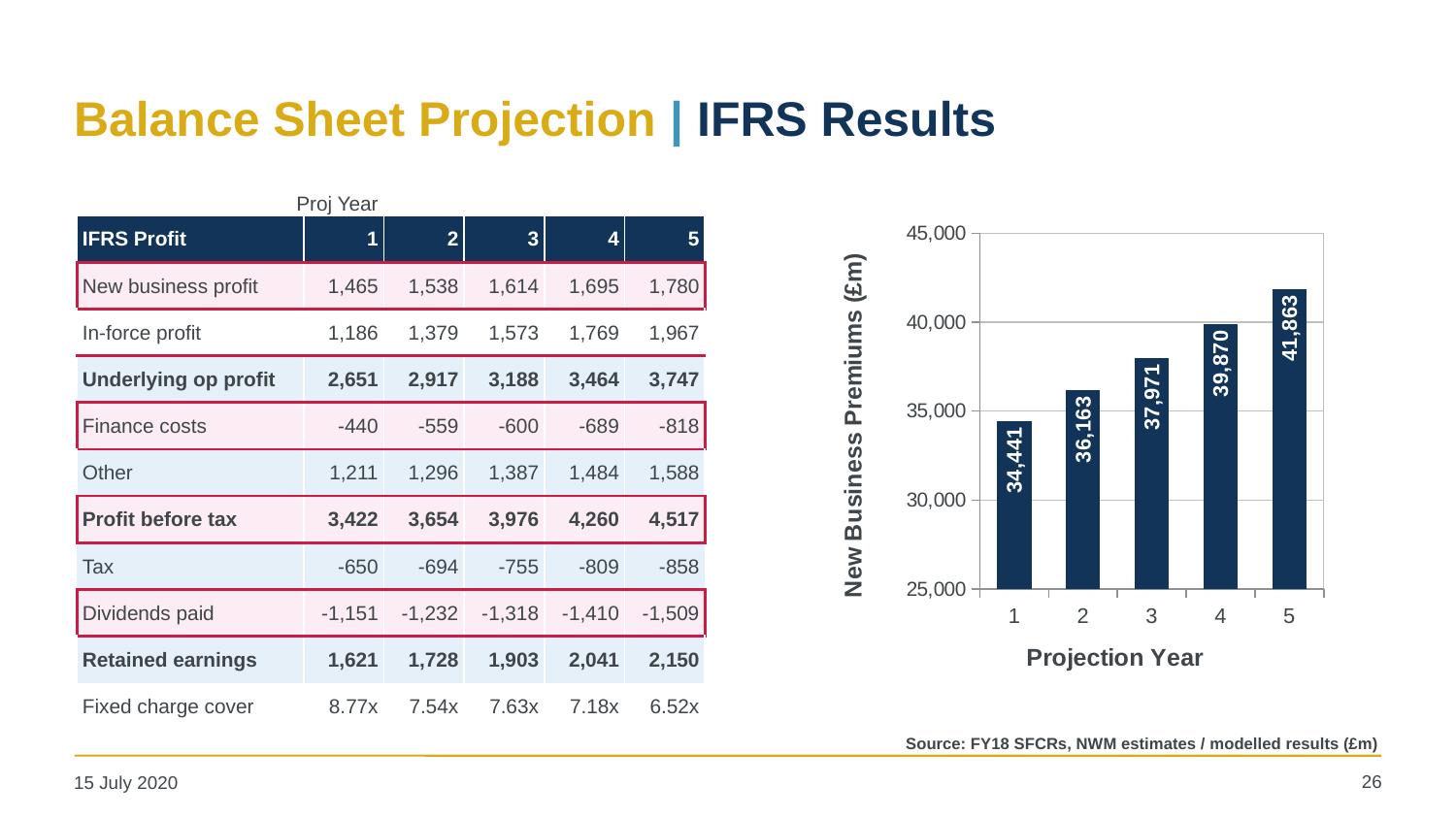
Which projection year has the lowest New Business Premiums? 1 How many projection years are shown in the chart? 5 What is the value of New Business Premiums (£m) for projection year 5? 41,863 What is the difference in New Business Premiums (£m) between projection year 4 and projection year 3? 1,899 Which projection year has the highest New Business Premiums? 5 Is the value for projection year 4 greater or less than 40,000? less What kind of chart is used to show New Business Premiums? Bar chart Do New Business Premiums rise or fall across the projection years? Rise What is the value of New Business Premiums (£m) for projection year 3? 37,971 Which is larger, New Business Premiums in projection year 2 or projection year 4? Projection year 4 What is the value of New Business Premiums (£m) for projection year 1? 34,441 What is the difference in New Business Premiums (£m) between projection year 5 and projection year 1? 7,422